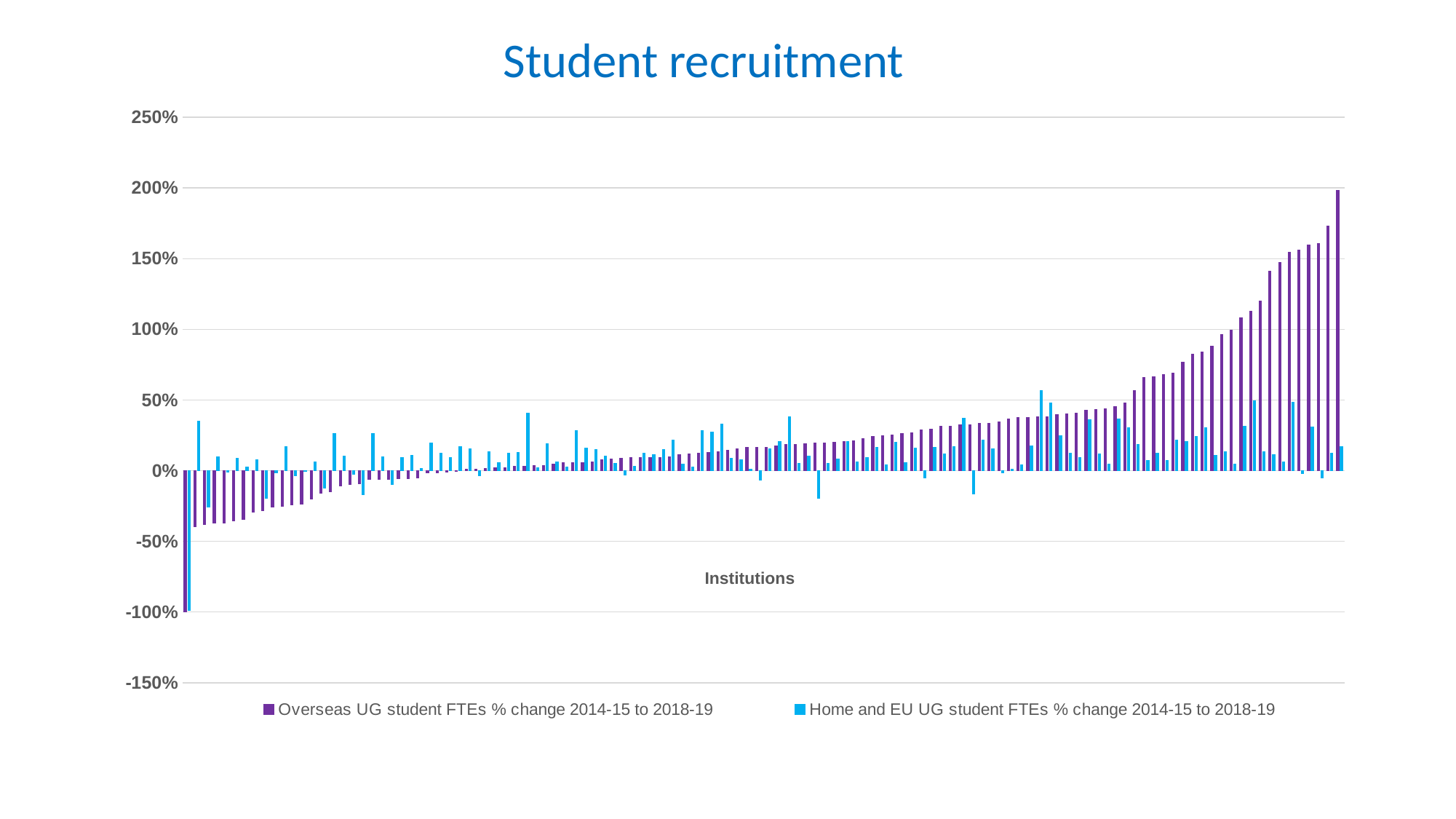
What is the title of the chart? Student recruitment Is the lowest bar in the Overseas UG student FTEs % change series greater or less than -50%? less Is the tallest bar in the Home and EU UG student FTEs % change series greater or less than 100%? less What is the label on the x axis of the chart? Institutions How many series does the legend list? 2 Which series contains the tallest bar on the chart, Overseas UG student FTEs % change or Home and EU UG student FTEs % change? Overseas UG student FTEs % change 2014-15 to 2018-19 What kind of chart is shown on the slide? Bar chart What is the highest value shown on the vertical axis? 250% Do the values for the Overseas UG student FTEs % change series rise or fall from left to right along the x axis? Rise Is the tallest bar in the Overseas UG student FTEs % change series greater or less than 150%? greater